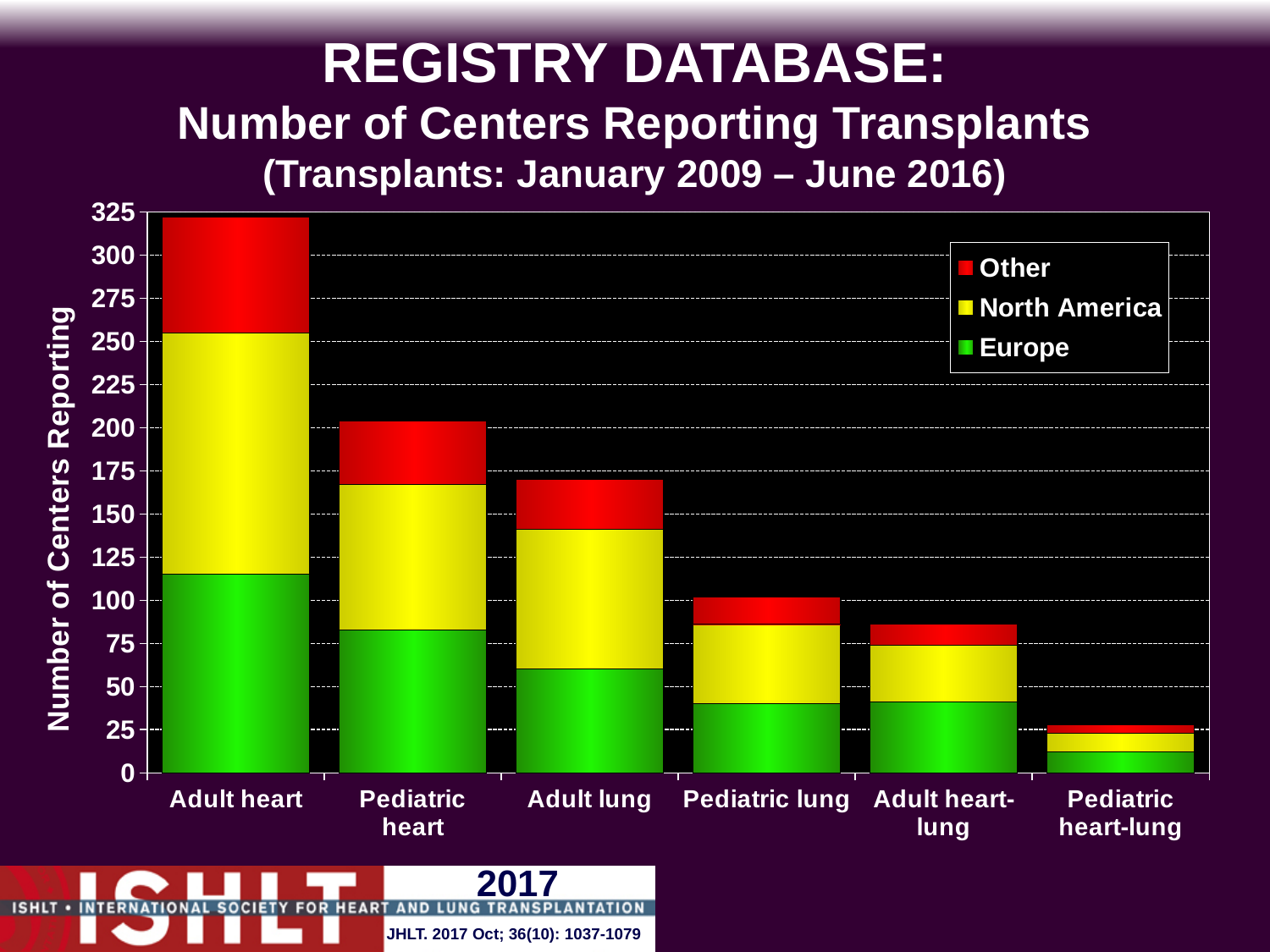
How many series does the legend list? 3 Which transplant category has the lowest total number of centers reporting? Pediatric heart-lung Is the total number of centers reporting for Pediatric heart-lung greater or less than 50? less Which transplant category has the highest total number of centers reporting? Adult heart Is the total number of centers reporting for Adult heart greater or less than 300? greater What kind of chart is shown on the slide? bar chart What is the title of the y axis? Number of Centers Reporting Which has a larger total number of centers reporting, Pediatric heart or Adult lung? Pediatric heart Is the total number of centers reporting for Pediatric heart greater or less than 175? greater How many transplant categories are shown along the x axis? 6 Which colour represents Europe in the legend? green